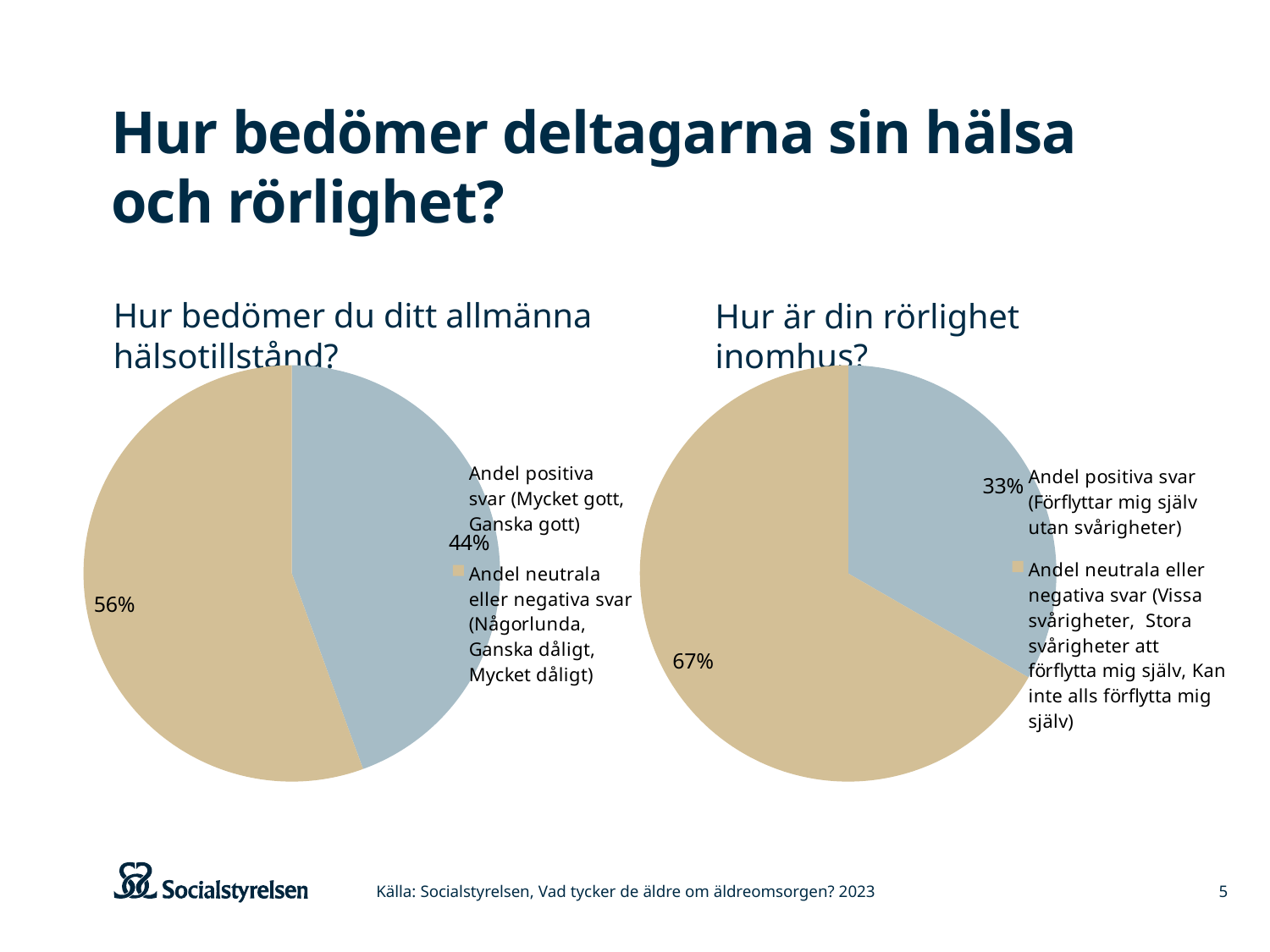
In the chart titled "Hur bedömer du ditt allmänna hälsotillstånd?", what share is labelled for "Andel positiva svar"? 44% What type of chart is used on the left side of the slide? Pie chart How many entries does the legend of the left chart list? 2 In the chart titled "Hur är din rörlighet inomhus?", what is the difference in percentage points between the two slices? 34 In the chart titled "Hur är din rörlighet inomhus?", what share is labelled for "Andel neutrala eller negativa svar"? 67% Which chart shows a larger share of positive answers, the left chart or the right chart? The left chart How many slices does the chart titled "Hur är din rörlighet inomhus?" have? 2 In the chart titled "Hur bedömer du ditt allmänna hälsotillstånd?", what share is labelled for "Andel neutrala eller negativa svar"? 56% In the chart titled "Hur är din rörlighet inomhus?", what share is labelled for "Andel positiva svar"? 33% In the chart titled "Hur bedömer du ditt allmänna hälsotillstånd?", what is the difference in percentage points between the two slices? 12 In the left chart, which slice is the largest? Andel neutrala eller negativa svar In the right chart, which slice is the smallest? Andel positiva svar